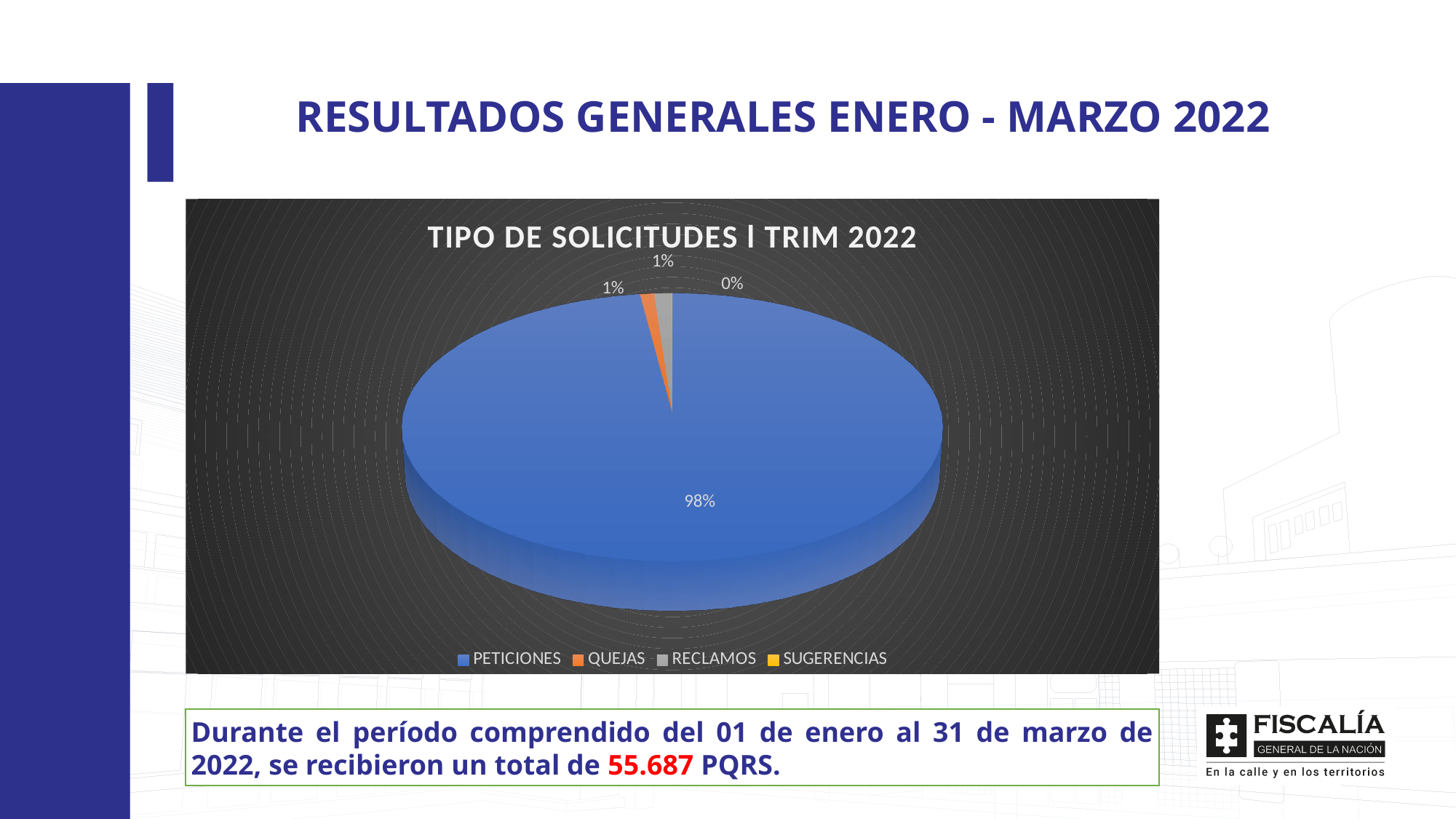
How many categories does the legend of the pie chart list? 4 What is the title of the chart? TIPO DE SOLICITUDES I TRIM 2022 What percentage is shown for SUGERENCIAS? 0% What percentage is shown for QUEJAS? 1% Which category has the largest share of the pie? PETICIONES Which colour represents PETICIONES in the pie chart? Blue What type of chart is shown on the slide? Pie chart What percentage is shown for RECLAMOS? 1% What is the difference in percentage points between PETICIONES and QUEJAS? 97 Which is larger, the share for PETICIONES or the share for QUEJAS? PETICIONES What share of the pie does PETICIONES represent? 98% Which category has the smallest share of the pie? SUGERENCIAS